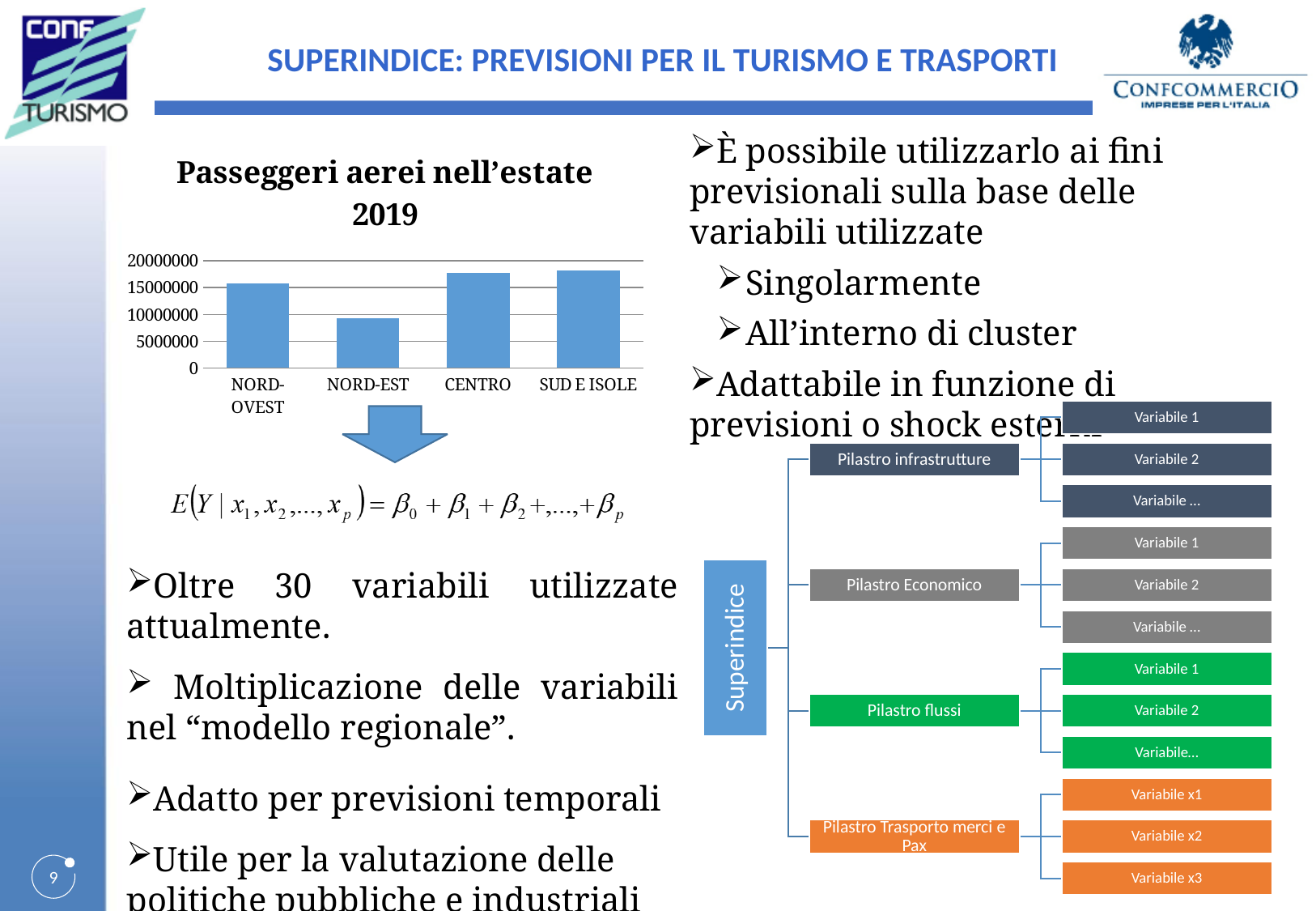
What kind of chart is used to show 'Passeggeri aerei nell'estate 2019'? Bar chart In the 'Passeggeri aerei nell'estate 2019' chart, which is larger: NORD-OVEST or NORD-EST? NORD-OVEST What is the title of the bar chart on the slide? Passeggeri aerei nell'estate 2019 In the 'Passeggeri aerei nell'estate 2019' chart, is the value for NORD-EST greater or less than 10000000? less In the 'Passeggeri aerei nell'estate 2019' chart, is the value for CENTRO greater or less than 15000000? greater In the 'Passeggeri aerei nell'estate 2019' chart, is the value for SUD E ISOLE greater or less than 15000000? greater Which category has the lowest value in the 'Passeggeri aerei nell'estate 2019' chart? NORD-EST In the 'Passeggeri aerei nell'estate 2019' chart, which is larger: CENTRO or NORD-EST? CENTRO In the 'Passeggeri aerei nell'estate 2019' chart, which is larger: SUD E ISOLE or NORD-OVEST? SUD E ISOLE How many categories are shown in the 'Passeggeri aerei nell'estate 2019' chart? 4